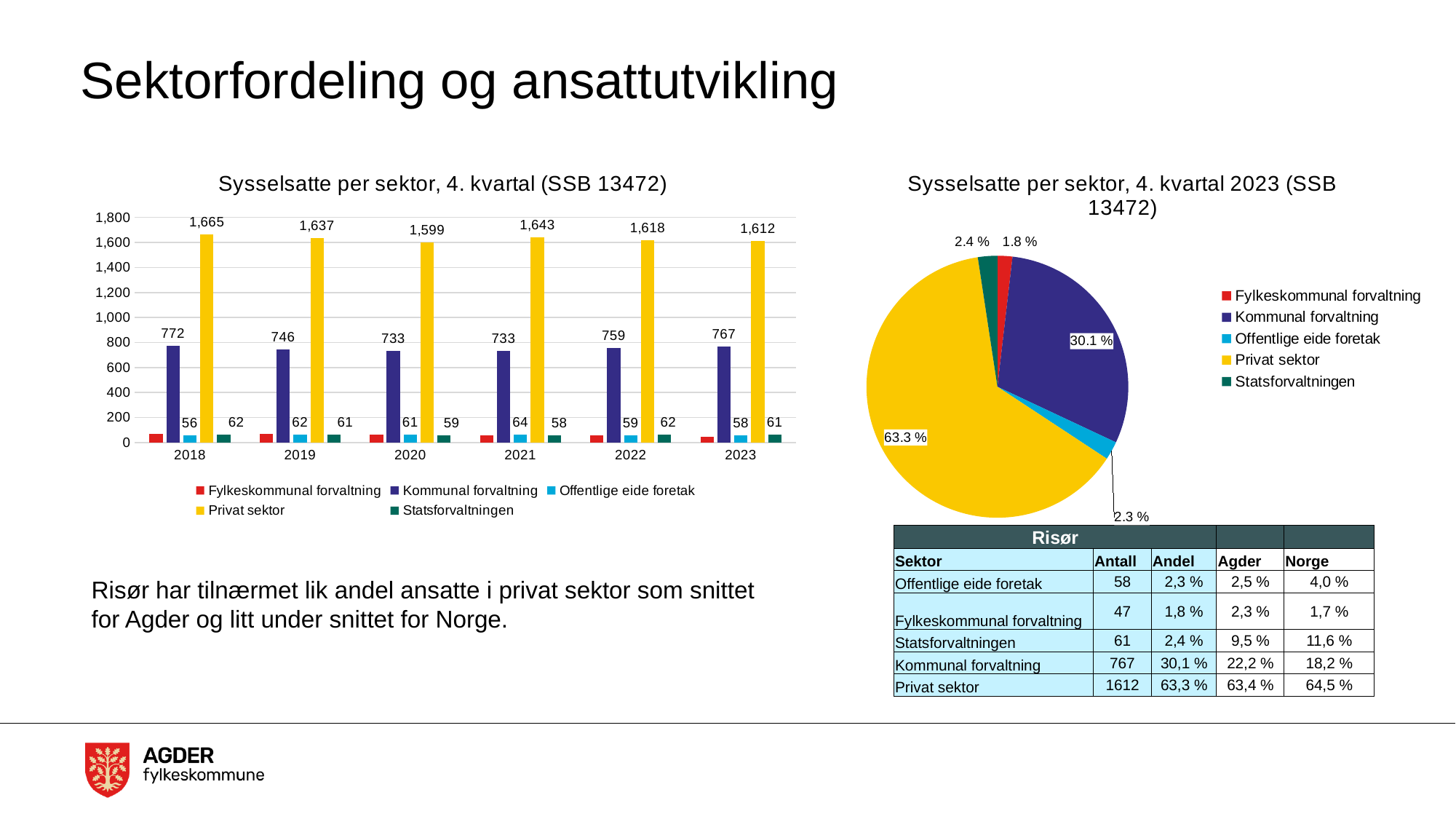
In the bar chart 'Sysselsatte per sektor, 4. kvartal (SSB 13472)', what is the value for Privat sektor in 2020? 1,599 What kind of chart is the chart on the right, 'Sysselsatte per sektor, 4. kvartal 2023 (SSB 13472)'? pie chart In the bar chart 'Sysselsatte per sektor, 4. kvartal (SSB 13472)', what is the difference between the Privat sektor values for 2018 and 2023? 53 In the bar chart 'Sysselsatte per sektor, 4. kvartal (SSB 13472)', what is the value for Kommunal forvaltning in 2023? 767 In the bar chart 'Sysselsatte per sektor, 4. kvartal (SSB 13472)', is the Kommunal forvaltning value for 2022 greater or less than 800? less In the bar chart 'Sysselsatte per sektor, 4. kvartal (SSB 13472)', how many years are shown on the x axis? 6 In the pie chart 'Sysselsatte per sektor, 4. kvartal 2023 (SSB 13472)', what share does Privat sektor have? 63.3 % In the pie chart 'Sysselsatte per sektor, 4. kvartal 2023 (SSB 13472)', which sector has the smallest slice? Fylkeskommunal forvaltning In the pie chart 'Sysselsatte per sektor, 4. kvartal 2023 (SSB 13472)', which colour represents Kommunal forvaltning? dark blue/purple In the bar chart 'Sysselsatte per sektor, 4. kvartal (SSB 13472)', which year has the highest value for Privat sektor? 2018 In the bar chart 'Sysselsatte per sektor, 4. kvartal (SSB 13472)', which year has the lowest value for Privat sektor? 2020 In the bar chart 'Sysselsatte per sektor, 4. kvartal (SSB 13472)', how many series does the legend list? 5